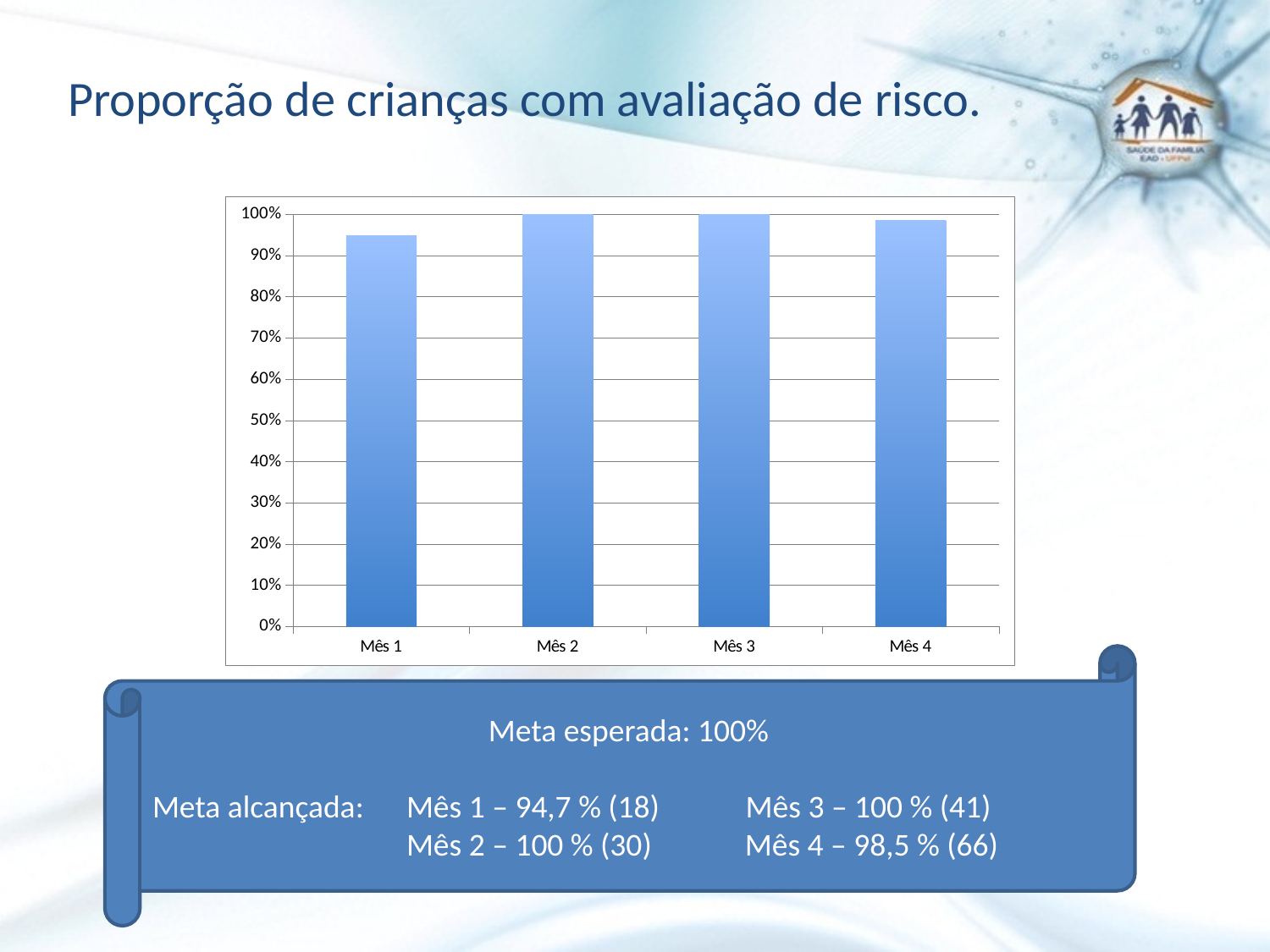
What is the value for Mês 1? 94,7 % Is the value for Mês 1 greater or less than 90%? greater What is the value for Mês 2? 100 % What is the title of the slide containing the chart? Proporção de crianças com avaliação de risco. Which is larger, the value for Mês 1 or the value for Mês 4? Mês 4 What is the difference between the value for Mês 2 and the value for Mês 1? 5,3 % What kind of chart is shown on the slide? bar chart Which month has the lowest value on the chart? Mês 1 Which months reach the highest value on the chart? Mês 2 and Mês 3 Does the value rise or fall from Mês 3 to Mês 4? fall What is the value for Mês 4? 98,5 % How many categories (months) are plotted on the chart? 4